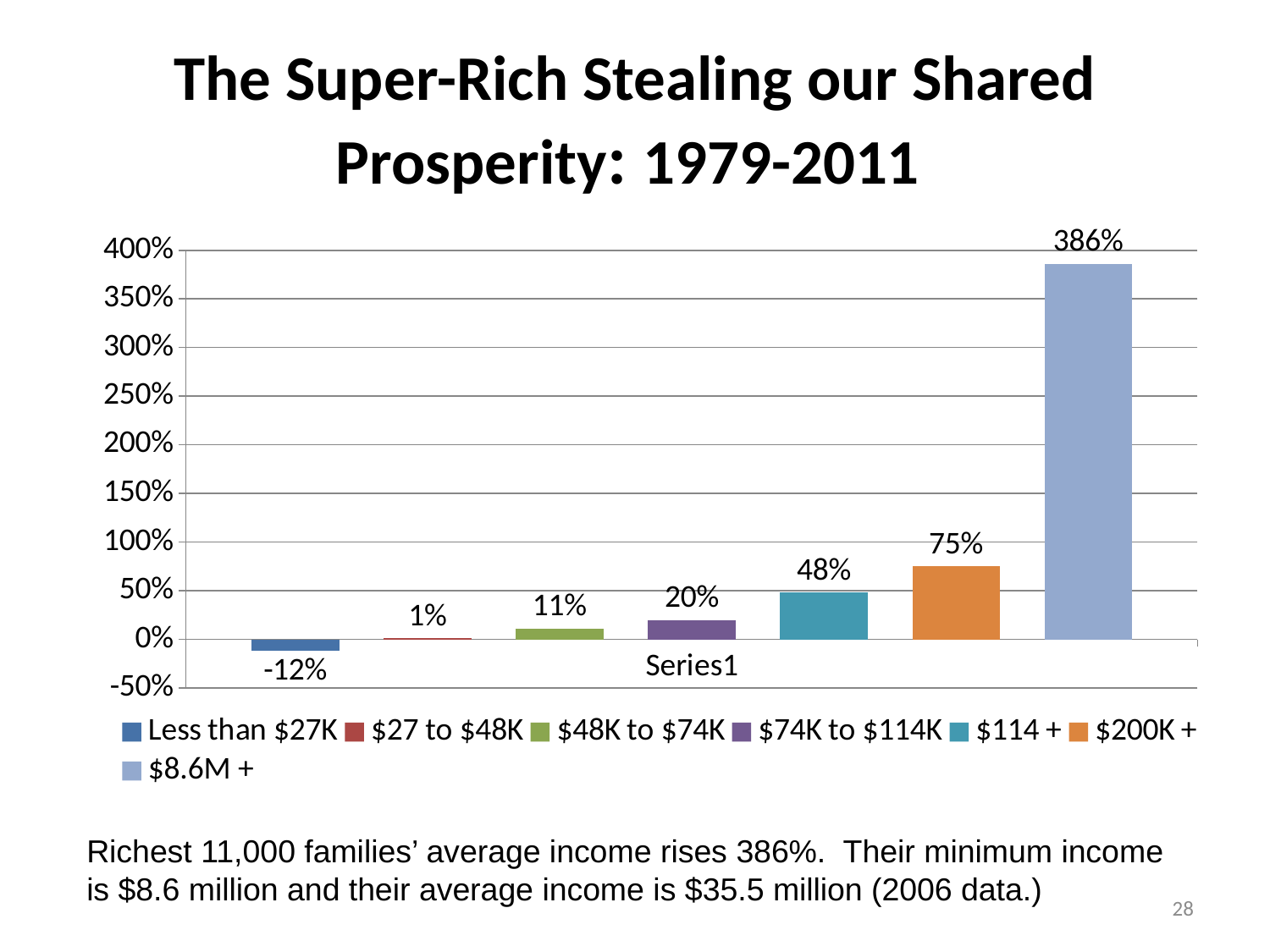
Is the value for $8.6M + greater or less than 350%? greater What is the value shown for the $200K + group? 75% What is the value shown for the $8.6M + group? 386% What is the difference between the values for $200K + and $114 +? 27% Which is larger, the value for $48K to $74K or the value for $27 to $48K? $48K to $74K Which group has the highest value on the chart? $8.6M + What is the value shown for the Less than $27K group? -12% What is the value shown for the $74K to $114K group? 20% What is the title of the chart on the slide? The Super-Rich Stealing our Shared Prosperity: 1979-2011 Which group has the lowest value on the chart? Less than $27K How many series does the legend list? 7 What kind of chart is shown on the slide? Bar chart